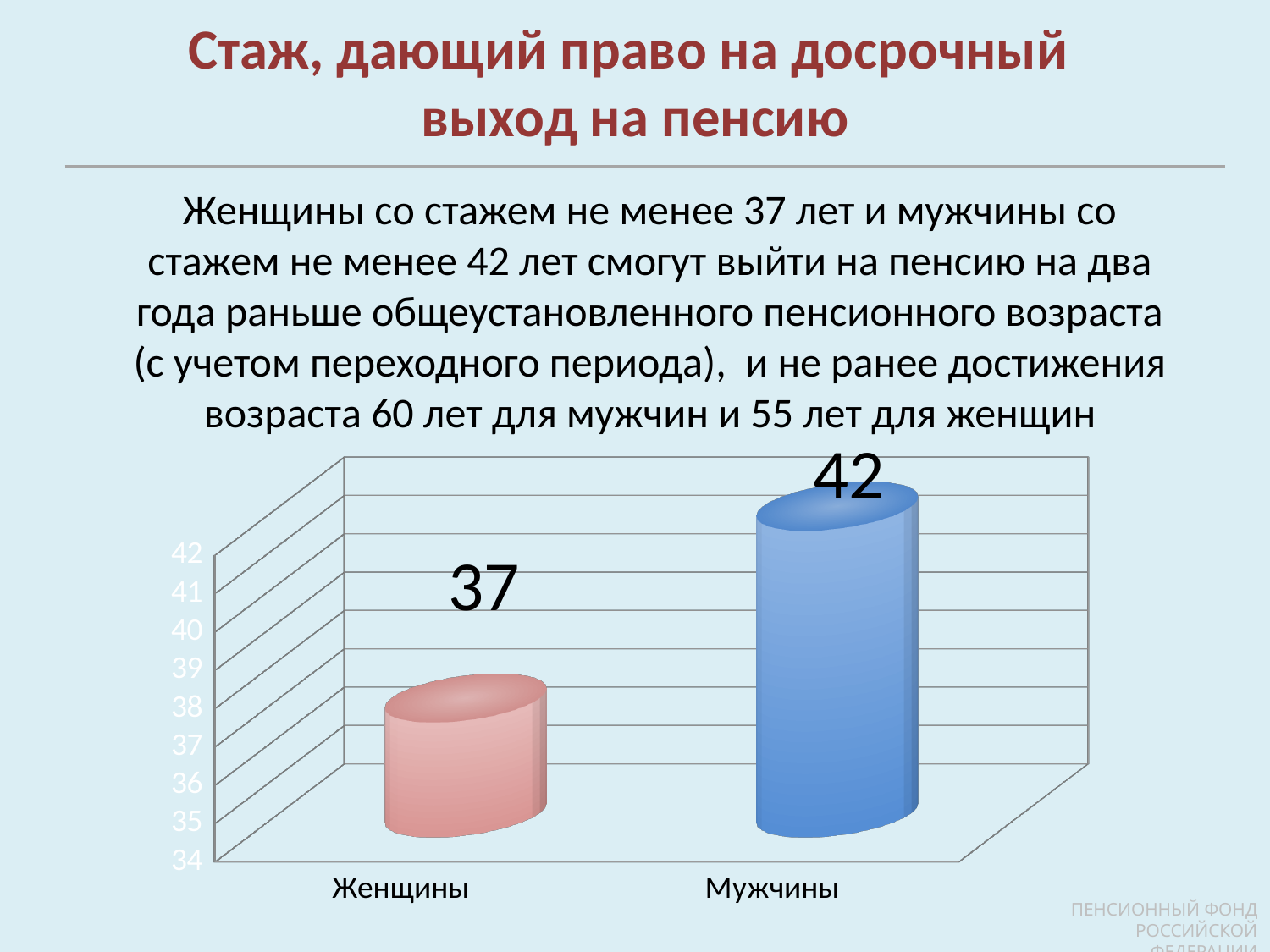
Which category has the lowest value? Женщины Is the value for Мужчины greater or less than 40? greater What kind of chart is shown on the slide? bar chart Which is larger, the value for Женщины or the value for Мужчины? Мужчины Is the value for Женщины greater or less than 40? less How many categories are shown on the x axis? 2 What is the value for Женщины? 37 What colour is the bar for Мужчины? blue What is the difference between the values for Мужчины and Женщины? 5 Which category has the highest value? Мужчины What is the value for Мужчины? 42 What is the lowest value shown on the vertical axis? 34